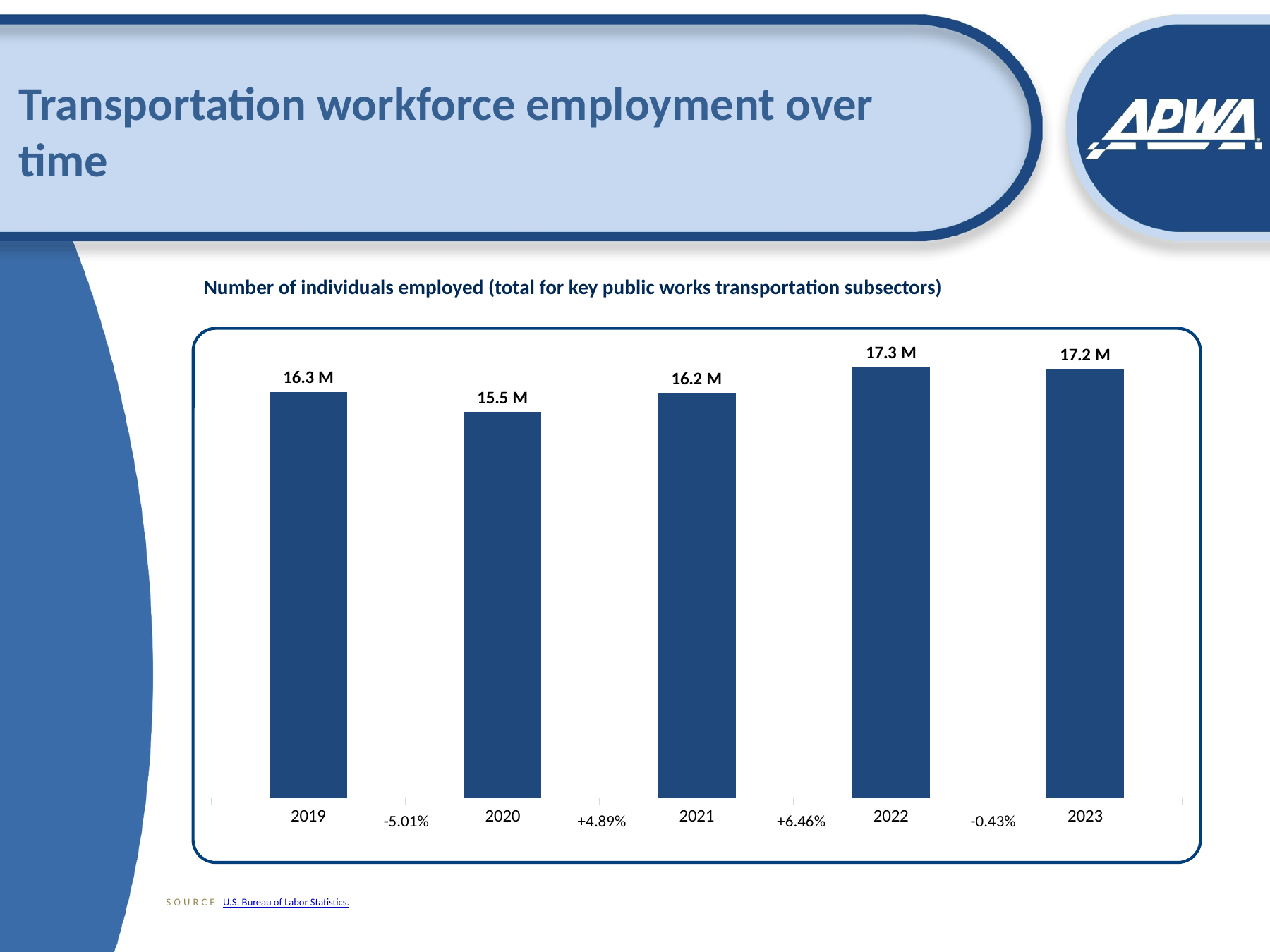
What is the number of individuals employed in 2022? 17.3 M What percentage change is shown between 2021 and 2022? +6.46% What is the number of individuals employed in 2020? 15.5 M What kind of chart is shown on the slide? Bar chart What is the difference in employment between 2022 and 2020? 1.8 M What is the number of individuals employed in 2019? 16.3 M How many years are shown on the chart? 5 What percentage change is shown between 2019 and 2020? -5.01% Which year has the lowest number of individuals employed? 2020 Which year has more individuals employed, 2019 or 2021? 2019 Which year has the highest number of individuals employed? 2022 What is the source cited for the chart? U.S. Bureau of Labor Statistics